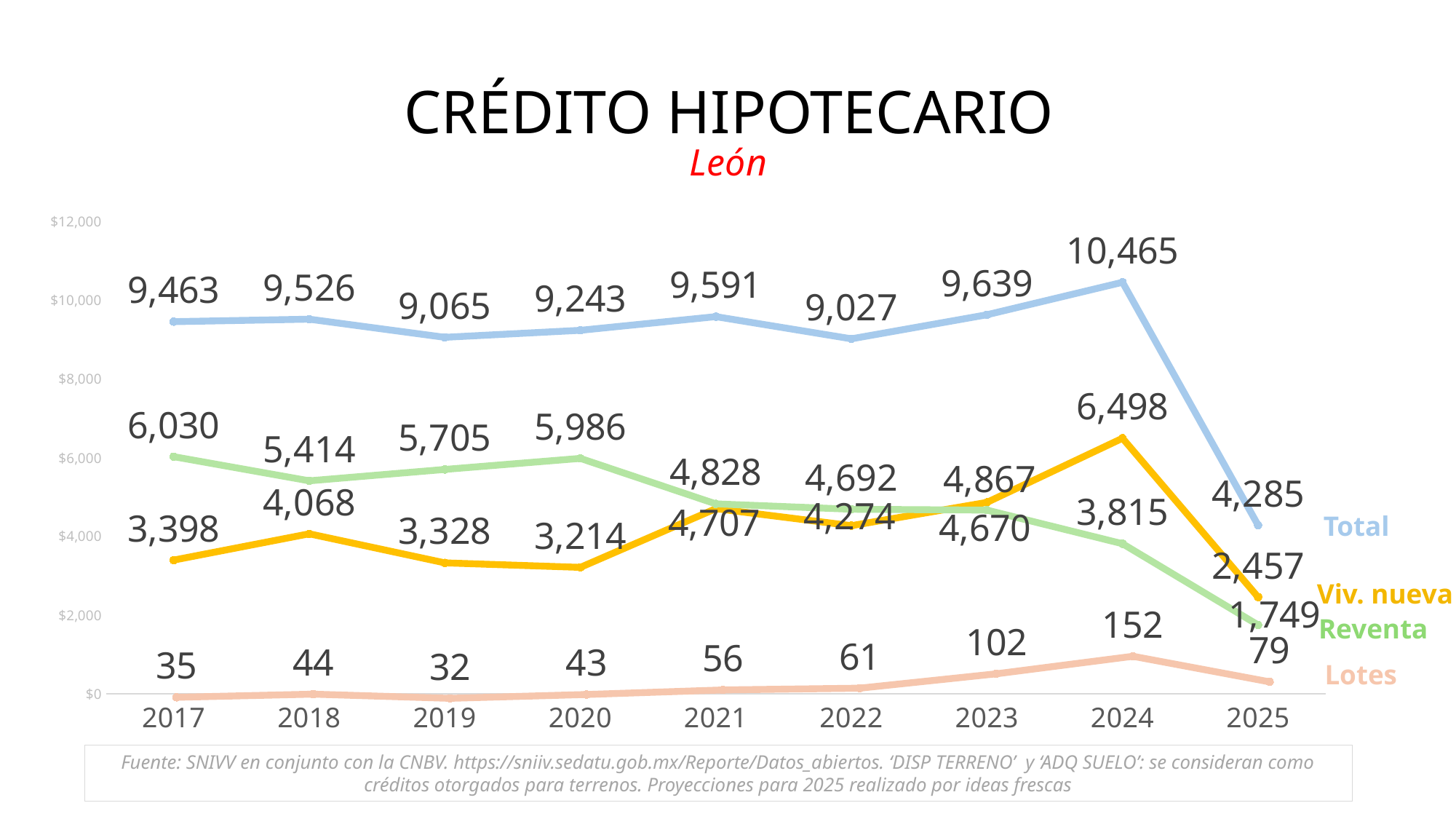
How many years are plotted along the x axis? 9 In which year is the Total series highest? 2024 What is the Reventa value for 2017? 6,030 What is the difference between the Total values for 2024 and 2025? 6,180 Which is larger in 2022, Reventa or Viv. nueva? Reventa How many series does the chart show? 4 In which year is the Lotes series lowest? 2019 What is the Lotes value for 2023? 102 What is the Total value for 2024? 10,465 Which series is shown in blue? Total What type of chart is shown on the slide? line chart What is the Viv. nueva value for 2024? 6,498